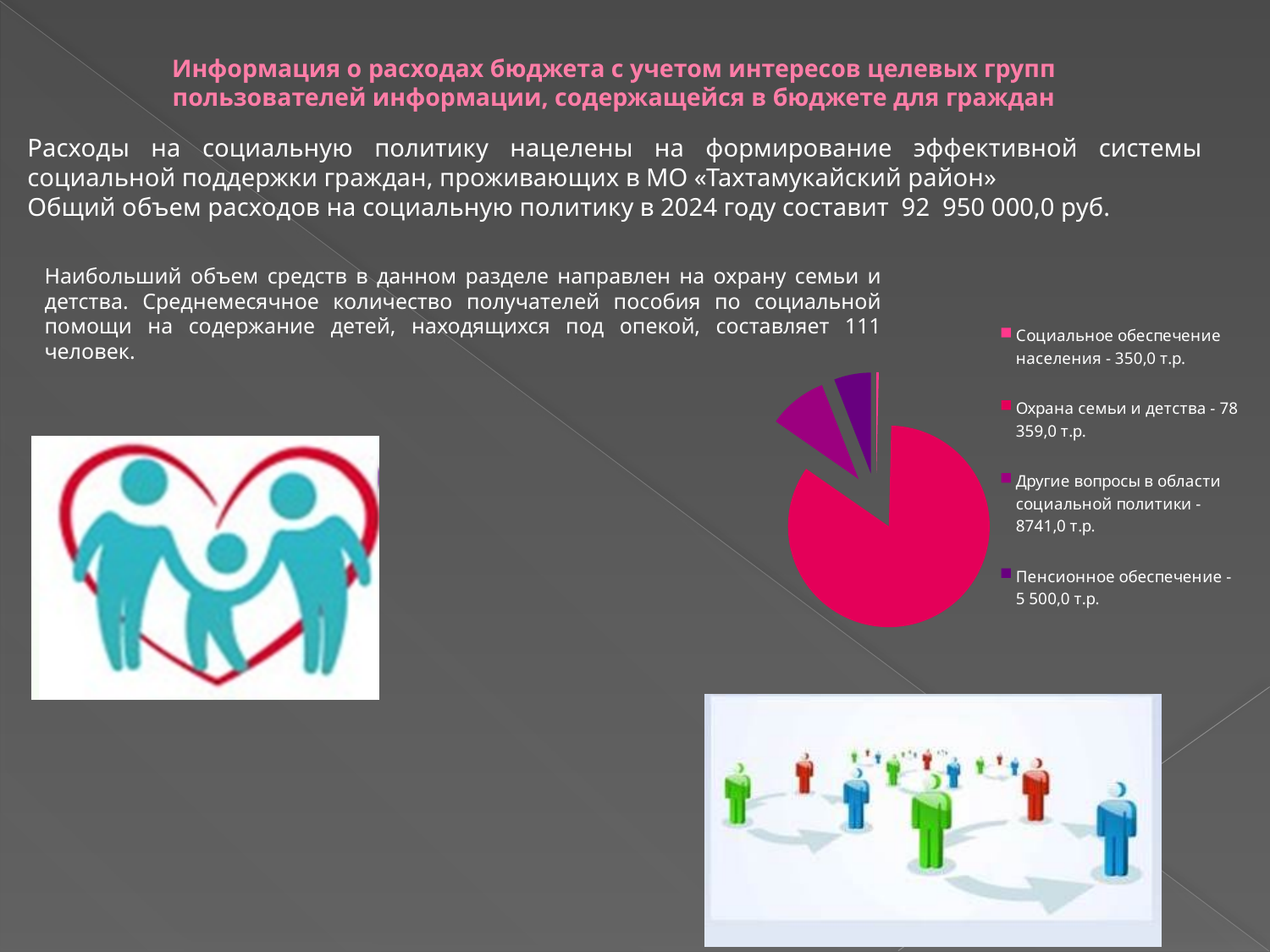
What is the difference between «Другие вопросы в области социальной политики» and «Пенсионное обеспечение» in the pie chart? 3 241,0 т.р. How many categories does the pie chart's legend list? 4 What value is given for «Другие вопросы в области социальной политики» in the pie chart legend? 8741,0 т.р. What colour is the slice for «Охрана семьи и детства» in the pie chart? Pink (magenta) What kind of chart is shown on the slide? Pie chart What value is given for «Охрана семьи и детства» in the pie chart legend? 78 359,0 т.р. What value is given for «Пенсионное обеспечение» in the pie chart legend? 5 500,0 т.р. Which category has the smallest value in the pie chart? Социальное обеспечение населения Which category has the largest slice of the pie chart? Охрана семьи и детства What value is given for «Социальное обеспечение населения» in the pie chart legend? 350,0 т.р. What is the difference between «Пенсионное обеспечение» and «Социальное обеспечение населения» in the pie chart? 5 150,0 т.р. Which is larger in the pie chart: «Другие вопросы в области социальной политики» or «Пенсионное обеспечение»? Другие вопросы в области социальной политики